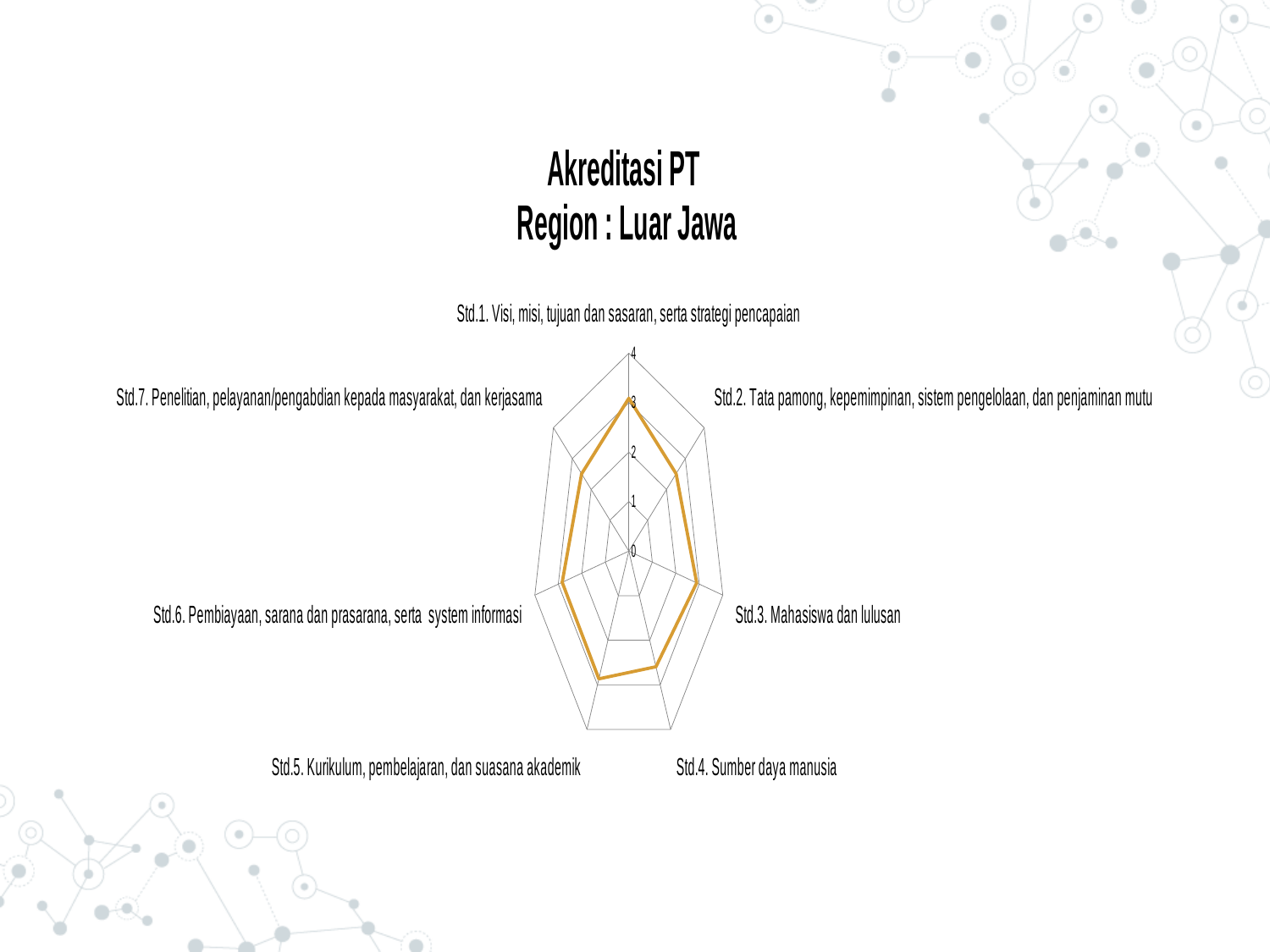
Is the value for Std.2. Tata pamong, kepemimpinan, sistem pengelolaan, dan penjaminan mutu greater or less than 4? less Is the value for Std.7. Penelitian, pelayanan/pengabdian kepada masyarakat, dan kerjasama greater or less than 2? greater Is the value for Std.6. Pembiayaan, sarana dan prasarana, serta system informasi greater or less than 2? greater How many standards (axes) are plotted on the radar chart? 7 What is the title of the chart? Akreditasi PT Region : Luar Jawa What kind of chart is shown on the slide? Radar chart What is the highest tick value shown on the chart's axis scale? 4